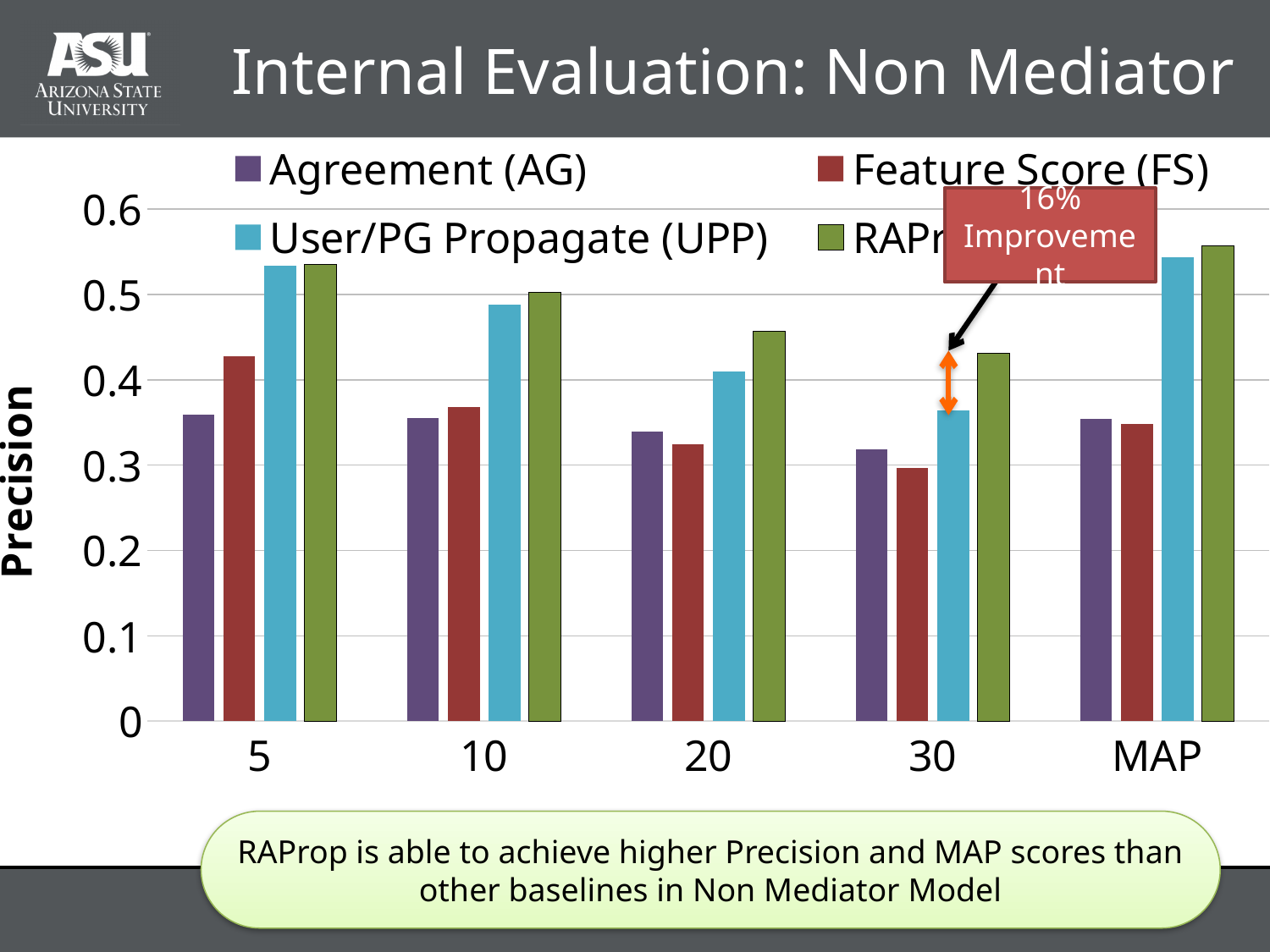
Which series has the lowest value at category 30? Feature Score (FS) Is the value for User/PG Propagate (UPP) at category 5 greater or less than 0.5? greater How many categories are shown along the x axis? 5 Is the value for RAProp at category MAP greater or less than 0.5? greater At category 30, which is larger: User/PG Propagate (UPP) or RAProp? RAProp At category 5, which is larger: Agreement (AG) or Feature Score (FS)? Feature Score (FS) Is the value for Agreement (AG) at category 5 greater or less than 0.3? greater How many series does the legend list? 4 What kind of chart is shown on the slide? bar chart What is the label of the y axis? Precision Do the values for Agreement (AG) rise or fall from category 5 to category 30? fall